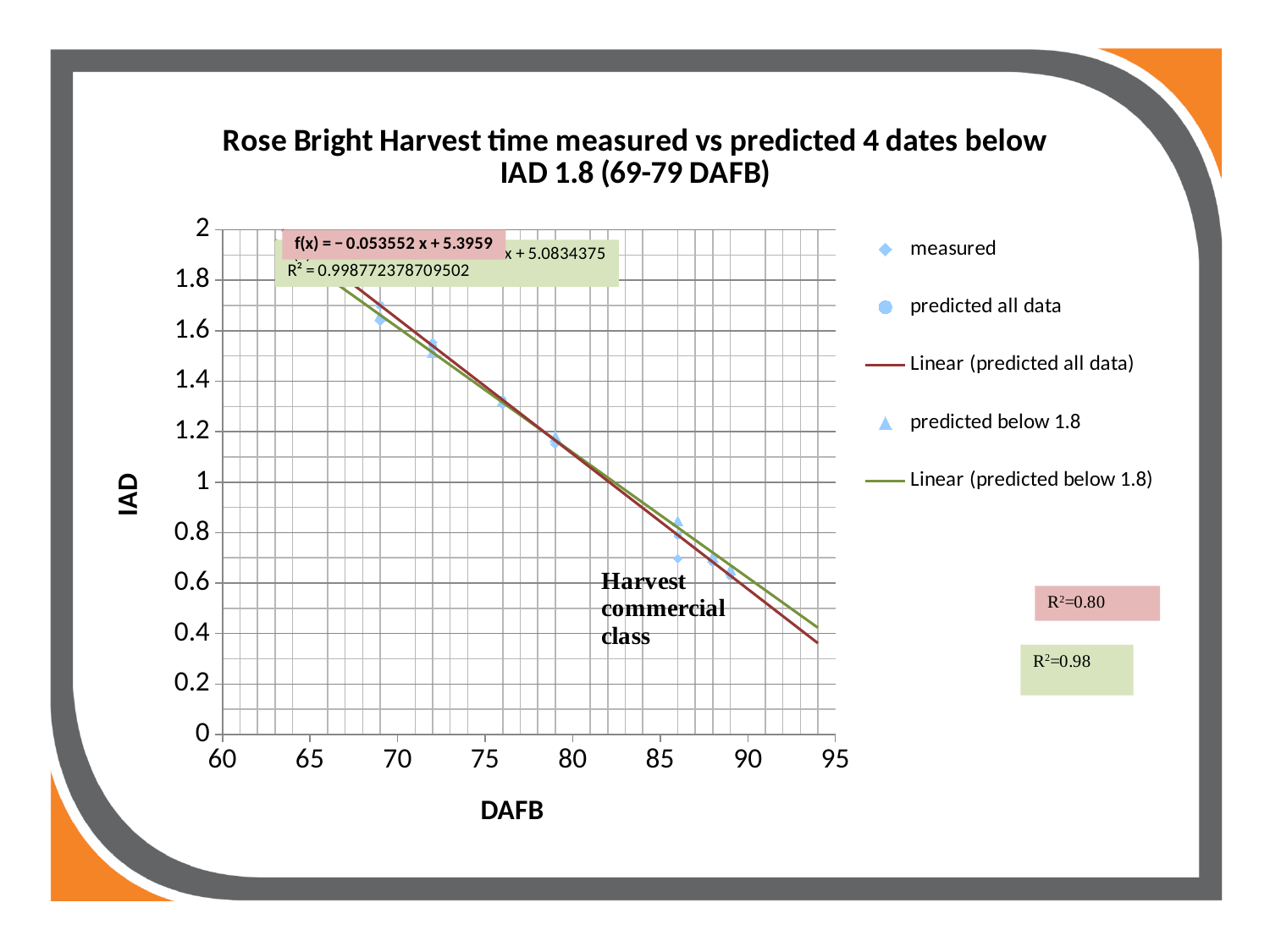
Is the measured IAD value at 69 DAFB greater or less than 1.4? greater Is the measured IAD value at 72 DAFB greater or less than 1.2? greater What is the intercept in the trend line equation f(x) printed on the chart? 5.3959 What is the label of the x axis? DAFB How many series does the legend list? 5 What kind of chart is shown on the slide? Scatter chart Do the IAD values rise or fall as DAFB increases? Fall Is the measured IAD value at 86 DAFB greater or less than 1? less What is the title of the chart? Rose Bright Harvest time measured vs predicted 4 dates below IAD 1.8 (69-79 DAFB) What is the slope in the trend line equation printed on the chart? −0.053552